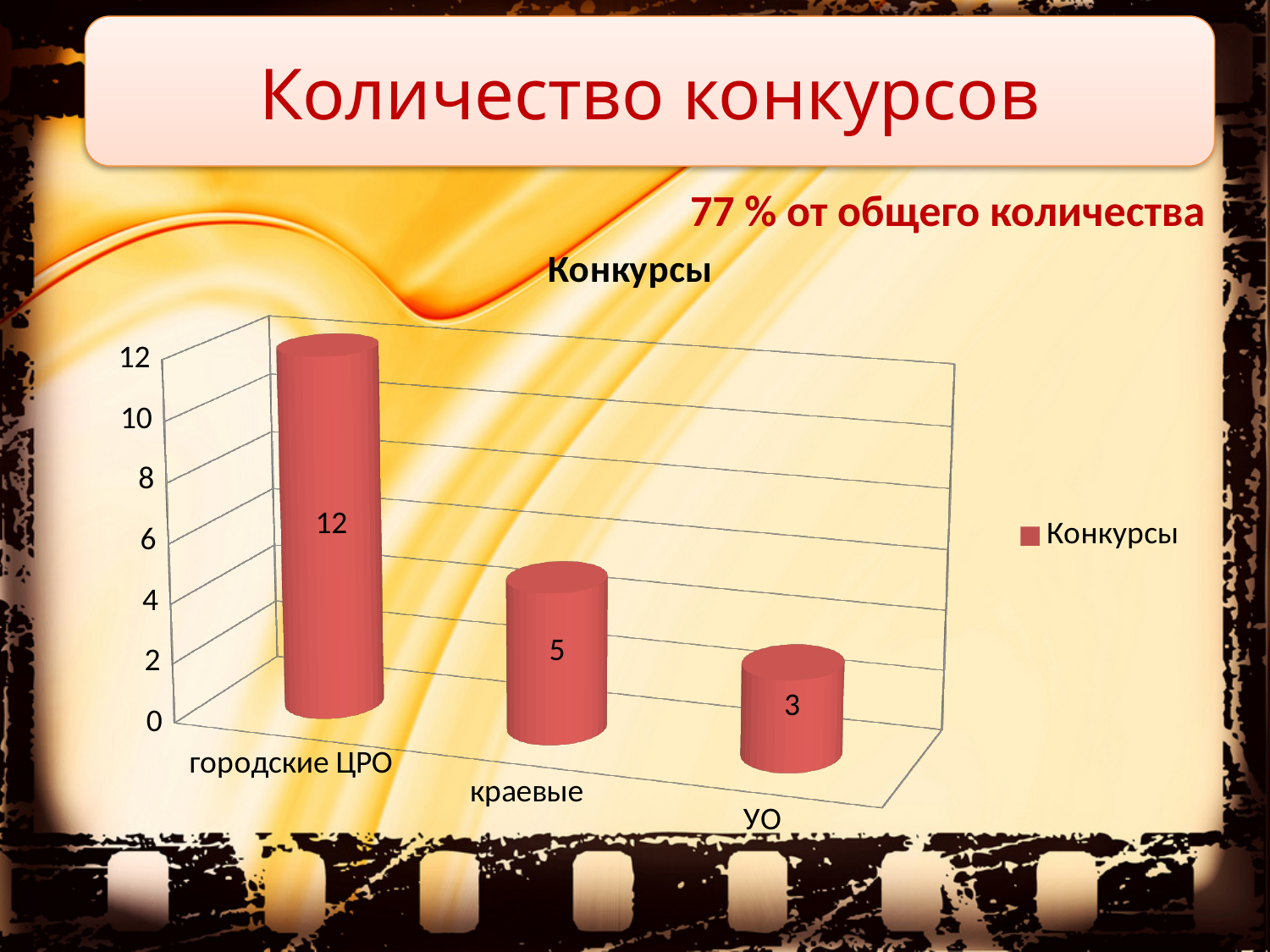
Which is larger, the value for краевые or the value for УО? краевые How many series does the legend list? 1 What is the difference between the values for краевые and УО? 2 What is the value for УО? 3 How many categories are shown on the chart? 3 What kind of chart is shown? bar chart Which category has the lowest value? УО Which category has the highest value? городские ЦРО What is the value for городские ЦРО? 12 What is the value for краевые? 5 What is the difference between the values for городские ЦРО and краевые? 7 What is the title of the chart? Конкурсы